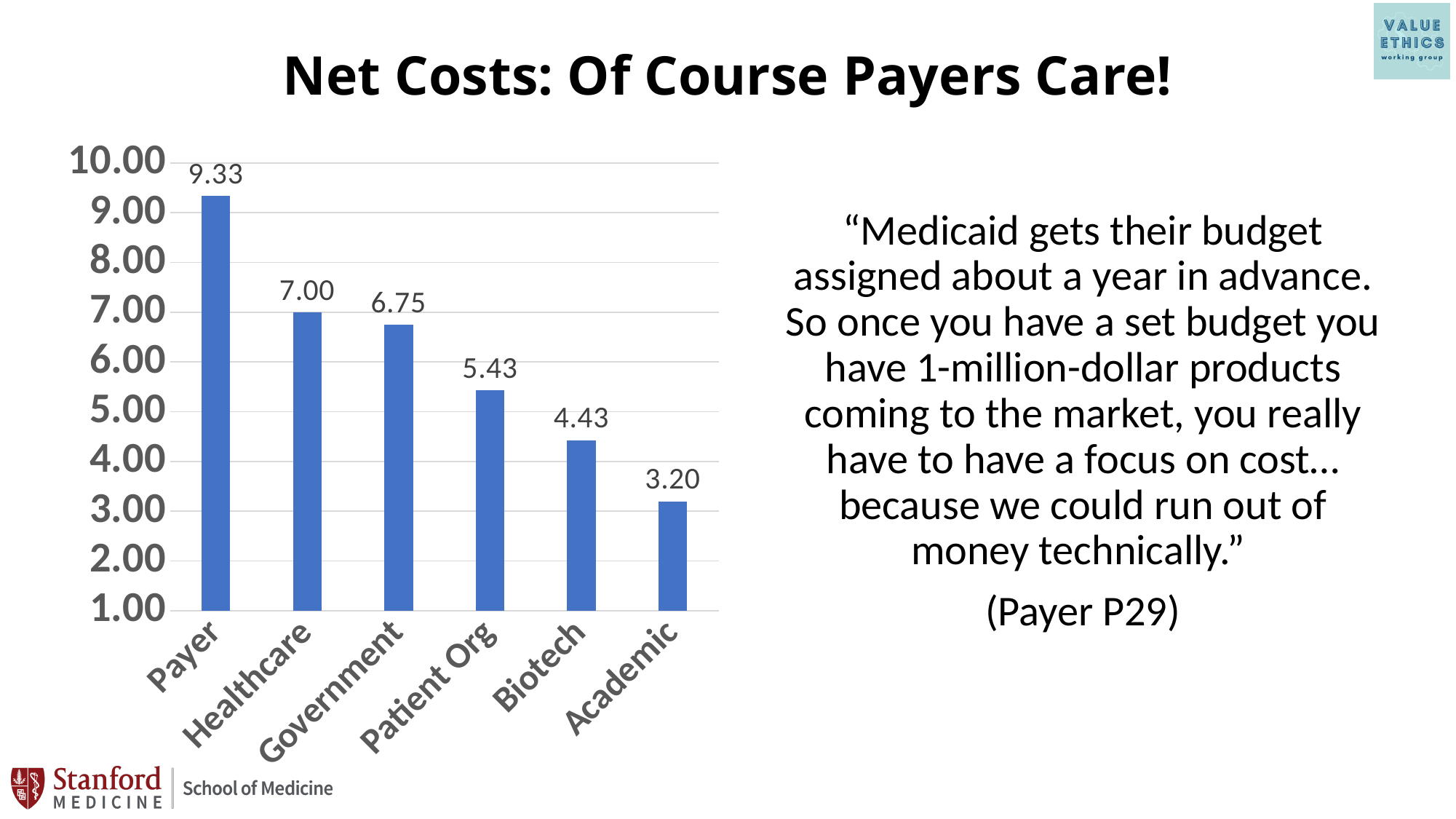
What is the difference between the values for Payer and Healthcare? 2.33 Which category has the highest value? Payer What is the difference between the values for Patient Org and Biotech? 1.00 What is the value for Payer? 9.33 Which category has the lowest value? Academic Which is larger, the value for Healthcare or the value for Government? Healthcare Is the value for Biotech greater or less than 5.00? less What is the value for Academic? 3.20 What kind of chart is shown on the slide? bar chart What is the value for Government? 6.75 How many categories are shown on the x axis? 6 Do the values rise or fall from left to right along the x axis? fall